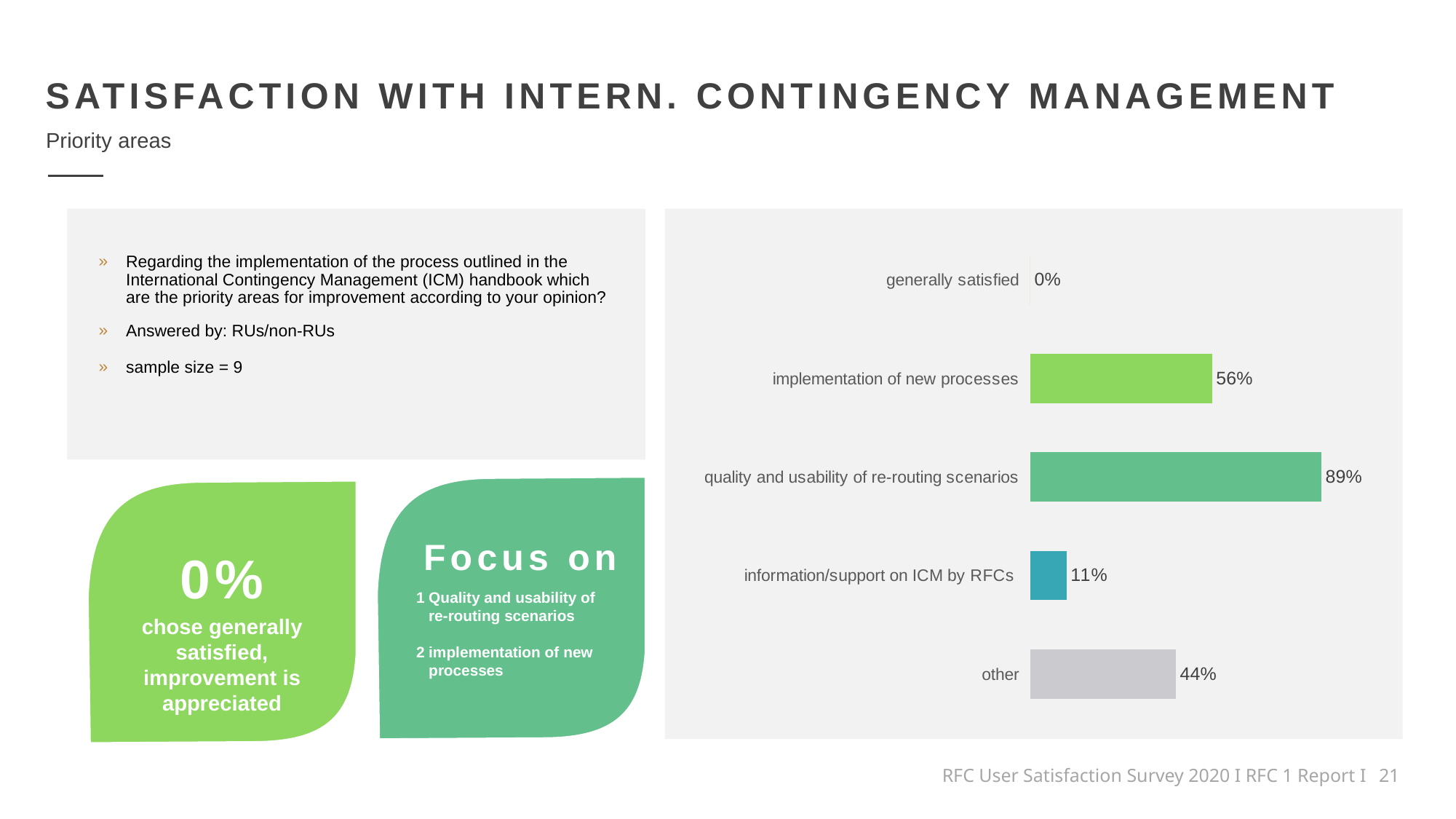
Which category has the lowest value? generally satisfied Which category has the highest value? quality and usability of re-routing scenarios What is the difference between "quality and usability of re-routing scenarios" and "implementation of new processes"? 33% What is the value for "implementation of new processes"? 56% What is the difference between "other" and "information/support on ICM by RFCs"? 33% What is the value for "generally satisfied"? 0% How many categories are shown in the chart? 5 What is the value for "quality and usability of re-routing scenarios"? 89% What is the value for "information/support on ICM by RFCs"? 11% What kind of chart is shown on the slide? bar chart Which is larger: "implementation of new processes" or "other"? implementation of new processes What is the value for "other"? 44%